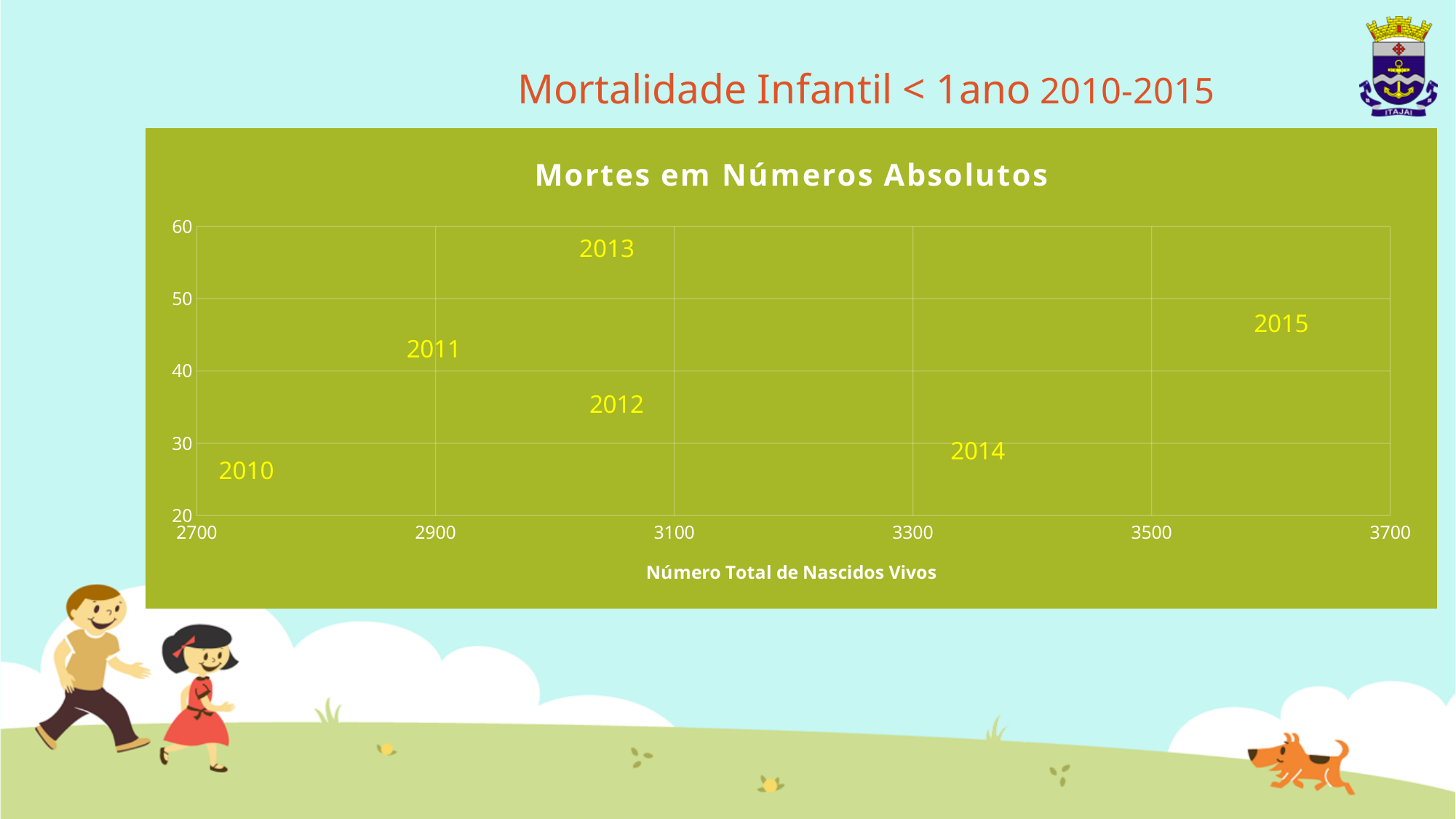
How many data points are plotted on the chart? 6 Which has a higher number of deaths, 2015 or 2012? 2015 What kind of chart is shown on the slide? scatter chart What is the title of the horizontal axis? Número Total de Nascidos Vivos Is the value for 2014 greater or less than 40? less Is the value for 2013 greater or less than 50? greater Is the value for 2015 greater or less than 40? greater Which has a higher number of deaths, 2013 or 2010? 2013 What is the title of the chart? Mortes em Números Absolutos Which year has the highest number of deaths on the chart? 2013